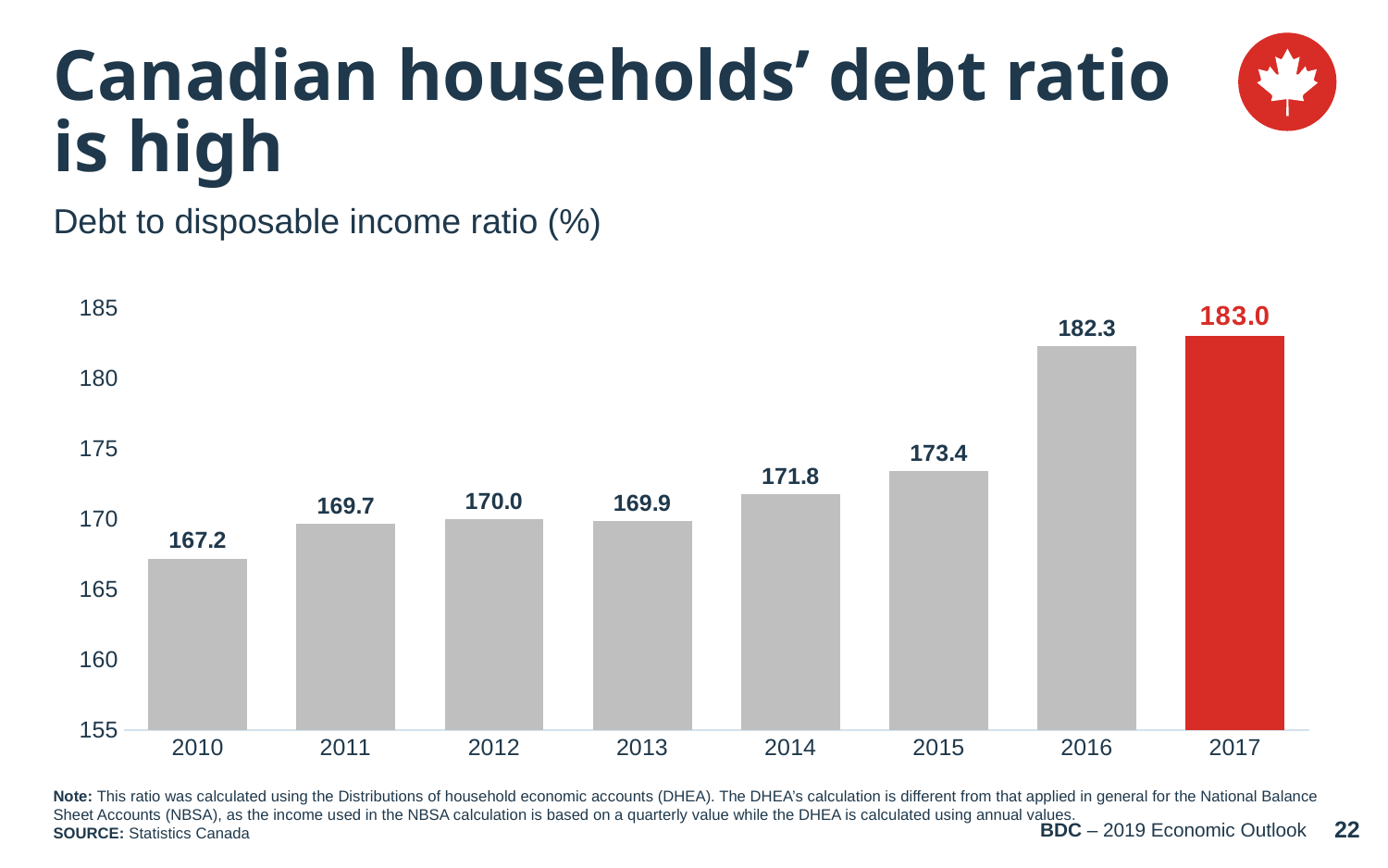
Which year has the highest debt to disposable income ratio? 2017 What is the difference between the 2016 value and the 2015 value? 8.9 Which year has the lowest debt to disposable income ratio? 2010 Is the value for 2016 greater or less than 180? greater What is the debt to disposable income ratio for 2010? 167.2 What kind of chart is shown on the slide? Bar chart What is the debt to disposable income ratio for 2014? 171.8 Which is larger, the value for 2013 or the value for 2015? 2015 Which bar is highlighted in red? 2017 How many years are shown on the chart? 8 What is the difference between the 2017 value and the 2010 value? 15.8 What is the value shown for 2017? 183.0